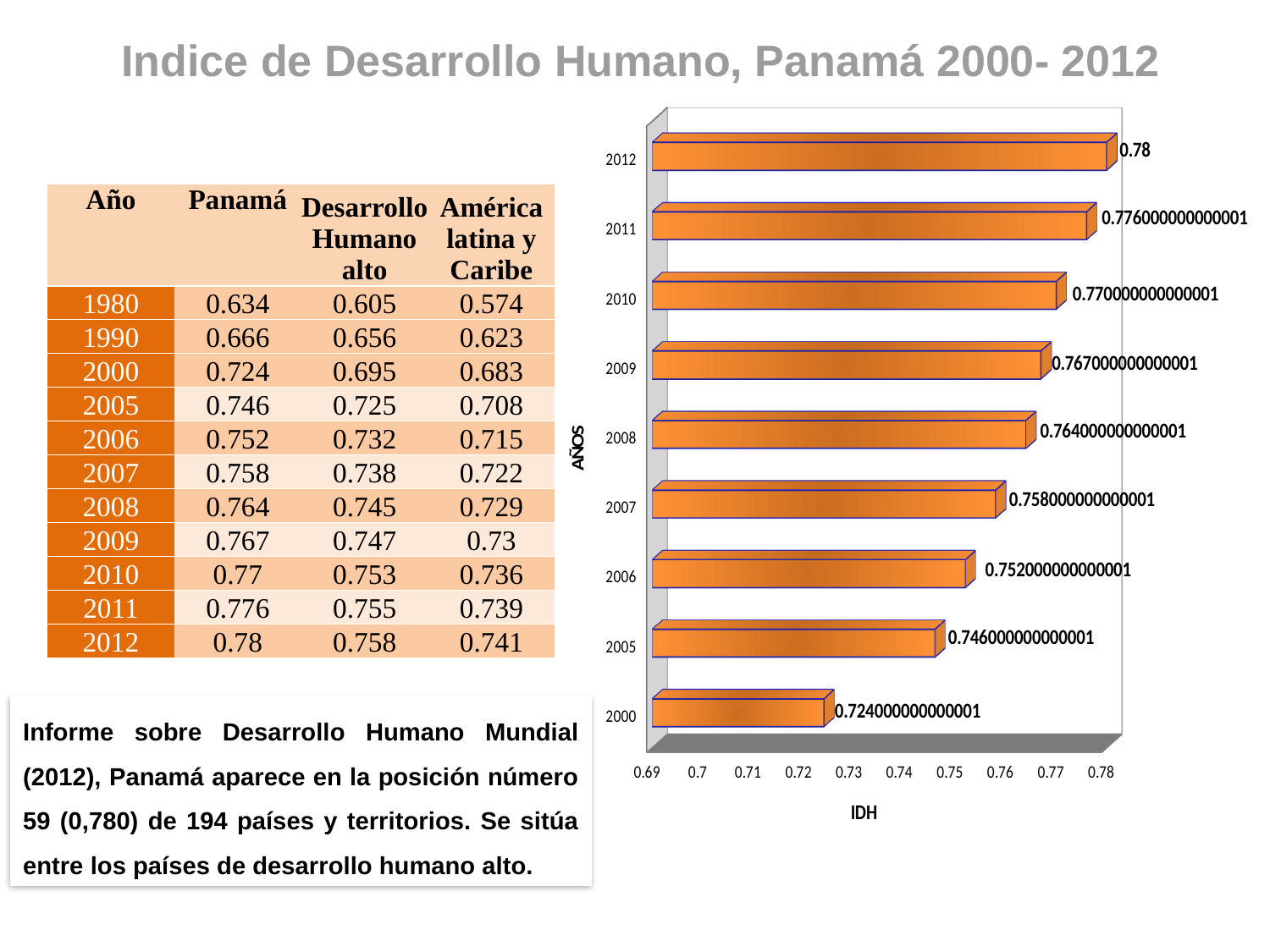
What type of chart is shown on the slide? bar chart Do the IDH values in the bar chart rise or fall from 2000 to 2012? rise Which year has the lowest IDH value in the bar chart? 2000 What is the data label shown for 2008 in the bar chart? 0.764000000000001 How many years (bars) are shown in the bar chart? 9 What is the label of the horizontal axis of the bar chart? IDH What is the data label shown for 2000 in the bar chart? 0.724000000000001 What is the IDH value shown for 2012 in the bar chart? 0.78 Is the IDH value for 2005 in the bar chart greater or less than 0.75? less In the bar chart, which year has a larger IDH value, 2007 or 2010? 2010 Is the IDH value for 2010 in the bar chart greater or less than 0.76? greater Which year has the highest IDH value in the bar chart? 2012